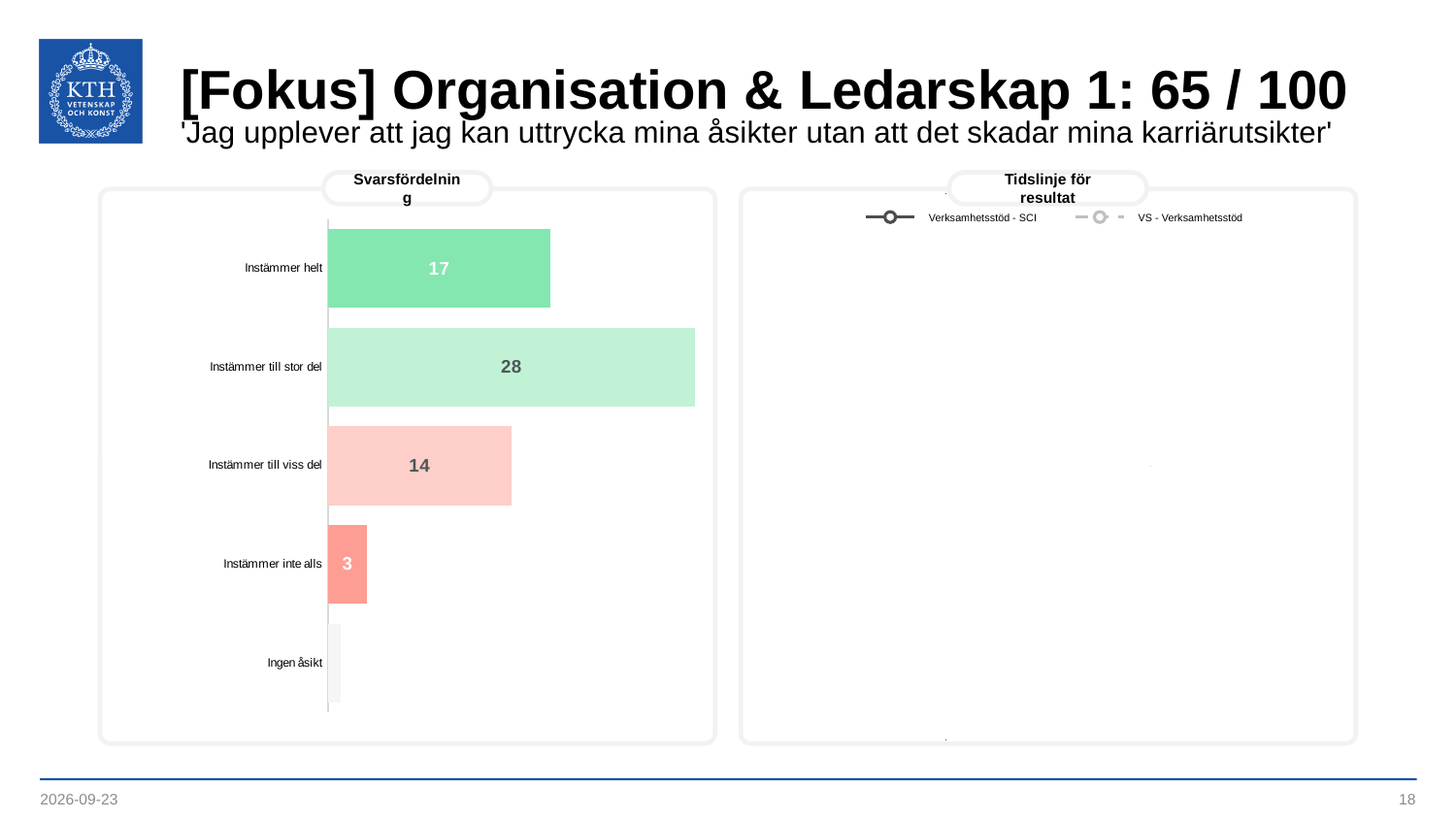
In the Svarsfördelning chart, what is the value for 'Instämmer inte alls'? 3 In the Svarsfördelning chart, which category has the lowest value? Ingen åsikt In the Svarsfördelning chart, what is the value for 'Instämmer till viss del'? 14 In the Svarsfördelning chart, what is the value for 'Instämmer helt'? 17 In the Svarsfördelning chart, what is the difference between 'Instämmer till stor del' and 'Instämmer helt'? 11 How many categories are shown in the Svarsfördelning chart? 5 How many series does the legend of the 'Tidslinje för resultat' chart list? 2 What kind of chart is the Svarsfördelning chart? Bar chart In the Svarsfördelning chart, what is the difference between 'Instämmer till viss del' and 'Instämmer inte alls'? 11 In the Svarsfördelning chart, what is the value for 'Instämmer till stor del'? 28 In the Svarsfördelning chart, which category has the highest value? Instämmer till stor del In the Svarsfördelning chart, which is larger: 'Instämmer helt' or 'Instämmer till viss del'? Instämmer helt